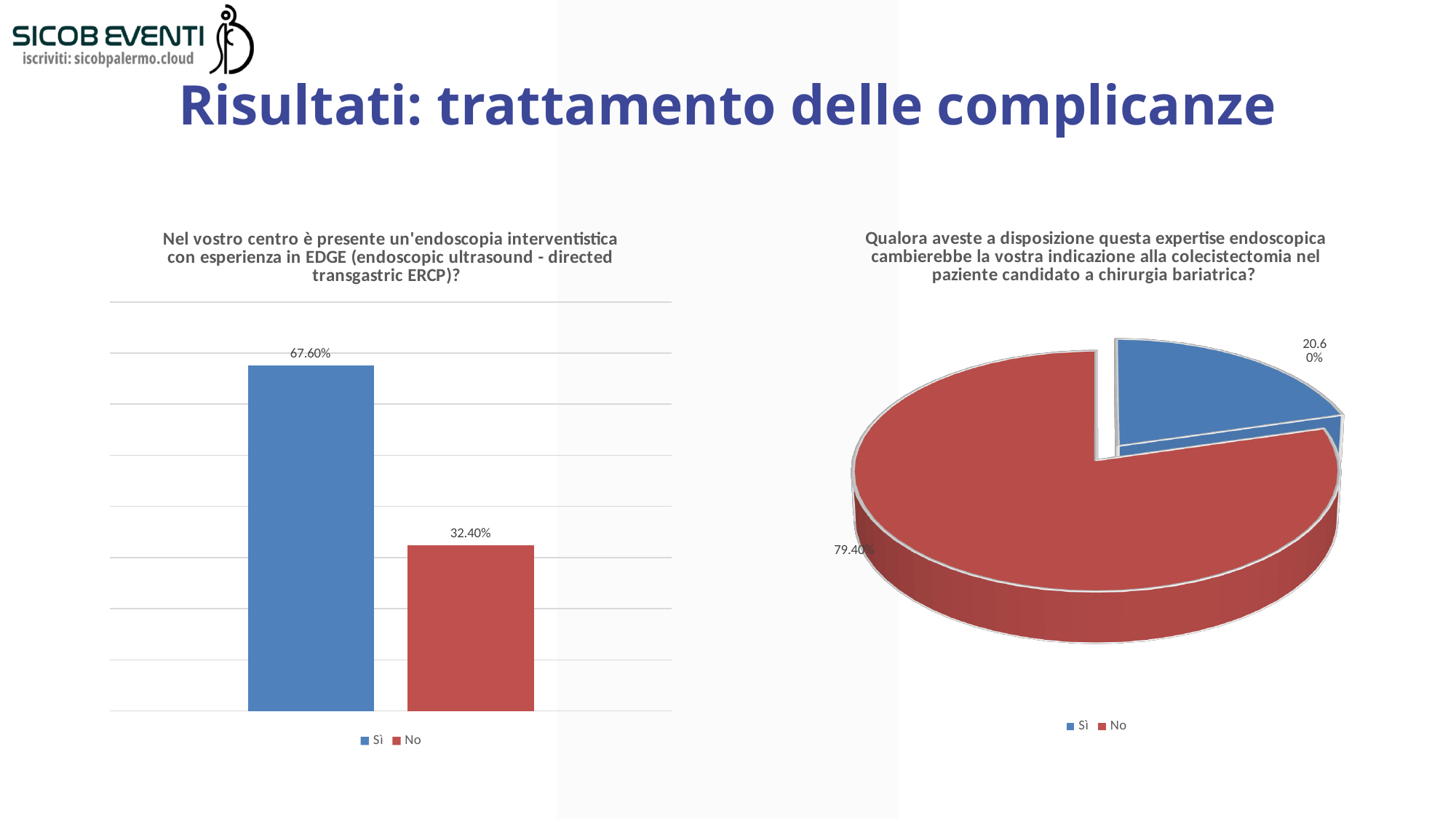
What kind of chart is the left chart (EDGE endoscopy question)? Bar chart How many bars are plotted in the left chart (EDGE endoscopy question)? 2 In the right chart (colecistectomia indication question), which slice is the smallest? Sì In the right chart (colecistectomia indication question), what share of the pie is Sì? 20.60% How many entries does the legend of the right chart (colecistectomia indication question) list? 2 In the left chart (EDGE endoscopy question), what is the value for No? 32.40% In the right chart (colecistectomia indication question), what share of the pie is No? 79.40% In the left chart (EDGE endoscopy question), what is the difference between Sì and No? 35.20% In the left chart (EDGE endoscopy question), which category has the highest value? Sì What kind of chart is the right chart (colecistectomia indication question)? Pie chart In the right chart (colecistectomia indication question), what colour is the No slice? Red In the left chart (EDGE endoscopy question), what is the value for Sì? 67.60%